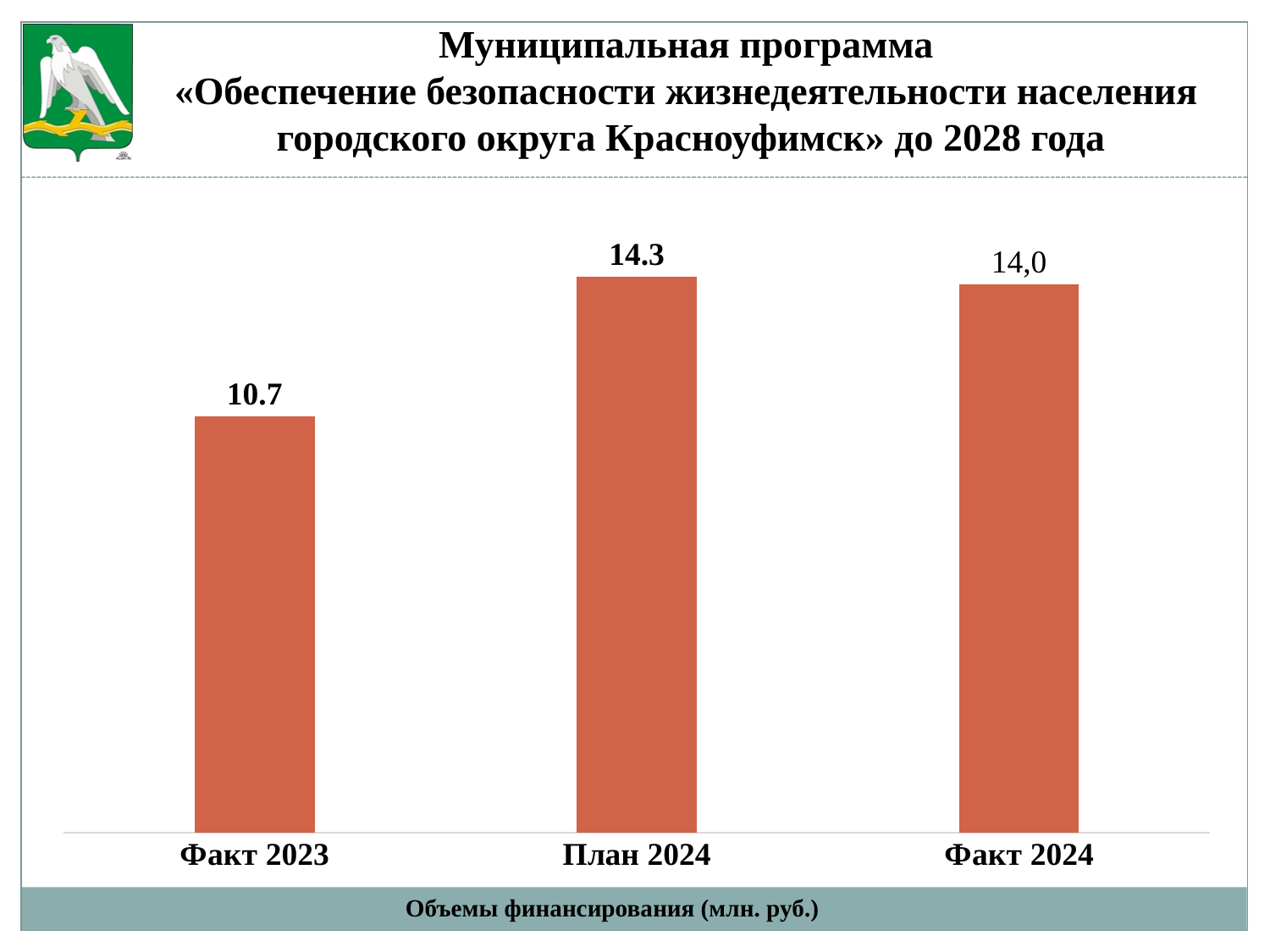
What is the value for Факт 2023? 10.7 What is the value for Факт 2024? 14,0 What is the value for План 2024? 14.3 How many bars are shown in the chart? 3 Which is larger, the value for Факт 2023 or the value for Факт 2024? Факт 2024 What is the difference between the values for План 2024 and Факт 2024? 0.3 Which category has the lowest value? Факт 2023 What is the difference between the values for Факт 2024 and Факт 2023? 3.3 What is the difference between the values for План 2024 and Факт 2023? 3.6 Which category has the highest value? План 2024 What unit of measurement is given in the caption below the chart? млн. руб. What kind of chart is shown on the slide? Bar chart